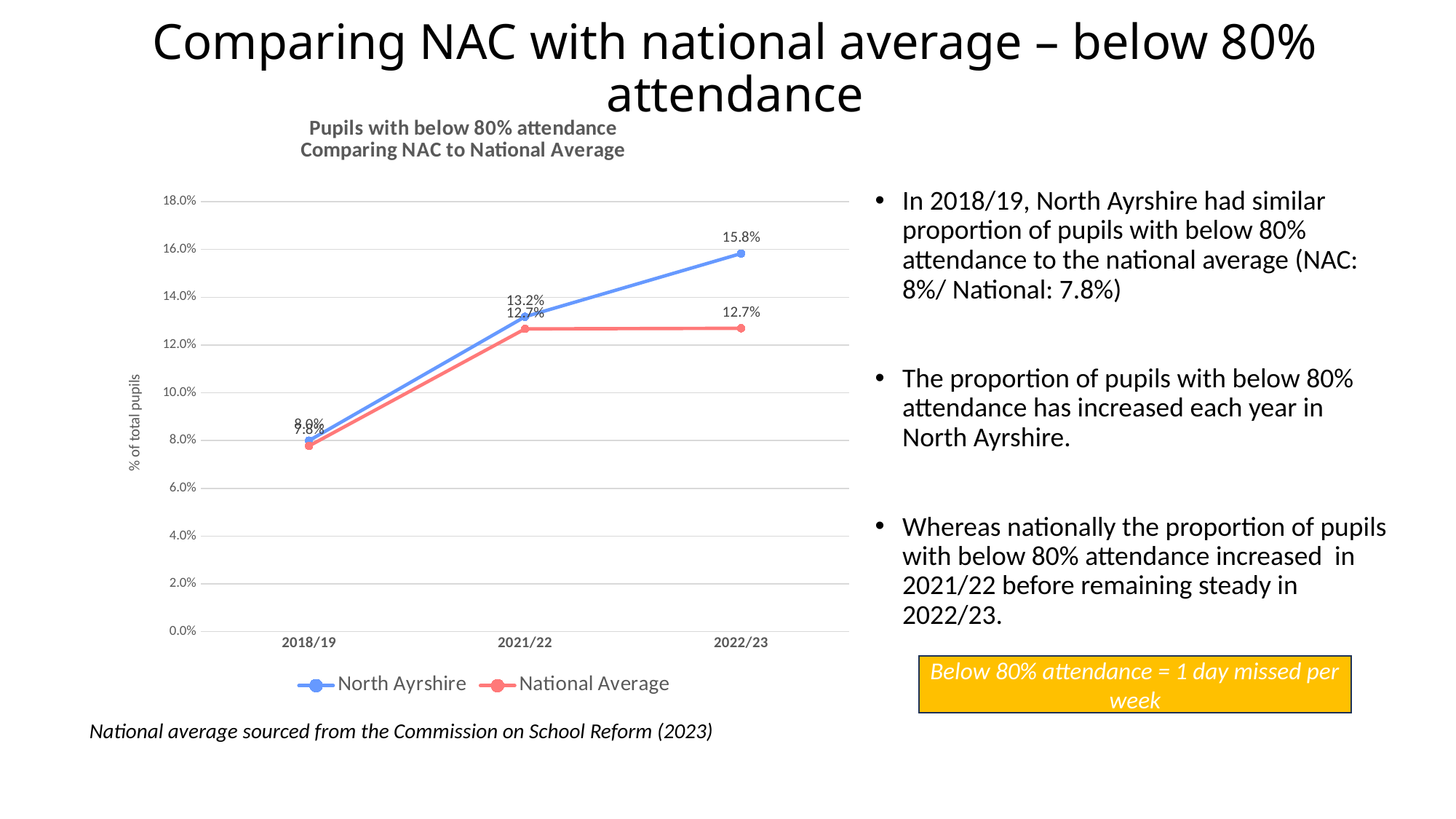
What is the value for North Ayrshire in 2022/23? 15.8% What is the value for the National Average in 2018/19? 7.8% Which series has the larger value in 2022/23, North Ayrshire or National Average? North Ayrshire What kind of chart is shown on the slide? Line chart How many years are plotted along the x axis of the chart? 3 Does the North Ayrshire line rise or fall from 2018/19 to 2022/23? Rise What is the difference between North Ayrshire and the National Average in 2022/23? 3.1% How many series does the chart legend list? 2 In which year is the North Ayrshire value highest? 2022/23 In which year is the National Average value lowest? 2018/19 What is the value for North Ayrshire in 2021/22? 13.2% What is the value for the National Average in 2022/23? 12.7%